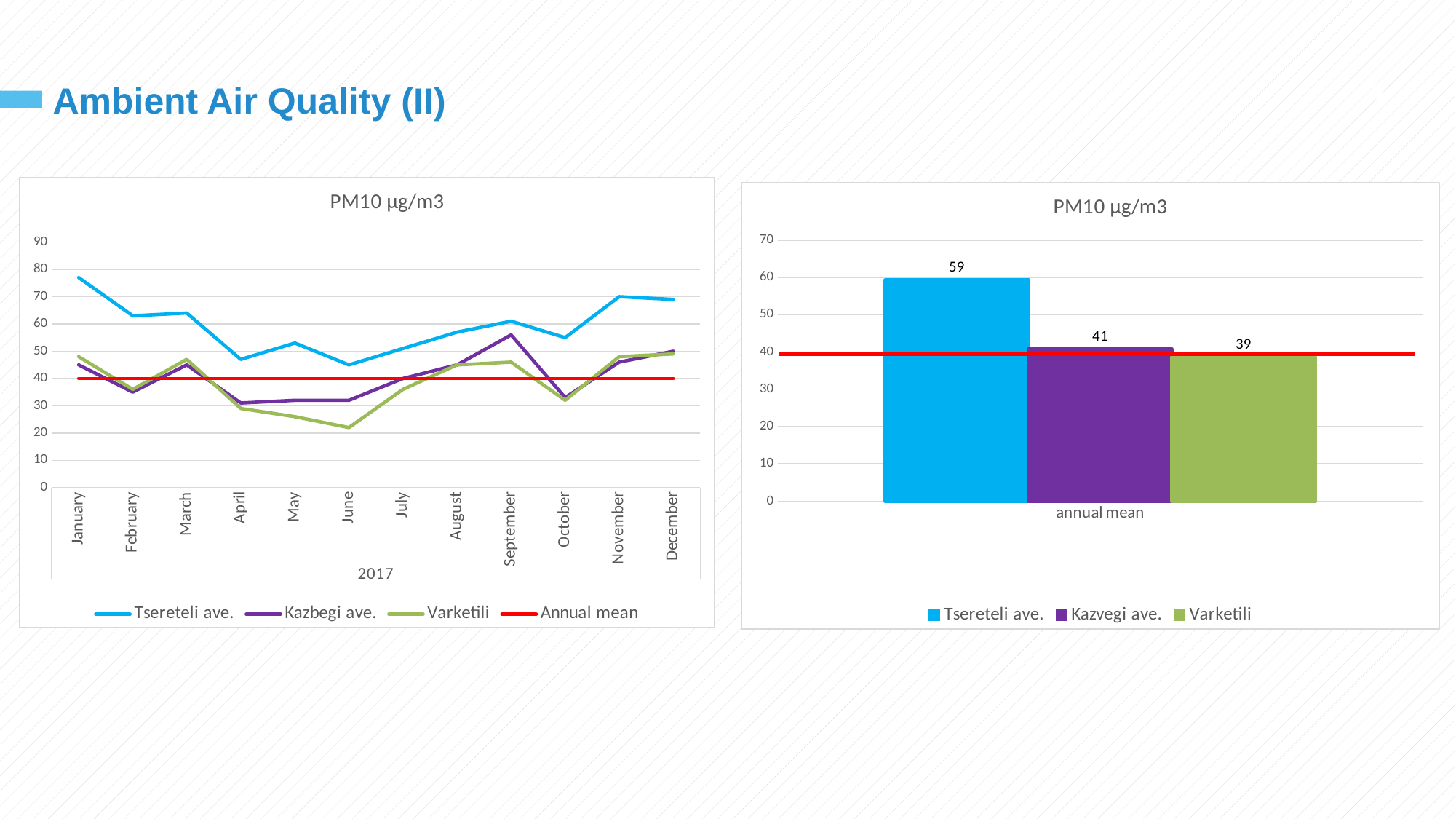
In the bar chart on the right, what is the annual mean PM10 value for Varketili? 39 In the bar chart on the right, what is the difference between the annual mean values for Tsereteli ave. and Kazvegi ave.? 18 In the bar chart on the right, what is the annual mean PM10 value for Tsereteli ave.? 59 In the line chart on the left, is the value for Varketili in June greater or less than 30? less In the line chart on the left, how many months are shown on the x axis? 12 In the bar chart on the right, which station has the lowest annual mean PM10 value? Varketili In the line chart on the left, what value does the red Annual mean line sit at? 40 In the line chart on the left, which series has the highest value in January? Tsereteli ave. In the line chart on the left, is the value for Tsereteli ave. in January greater or less than 70? greater In the bar chart on the right, how many series does the legend list? 3 What kind of chart is the chart on the left of the slide? line chart In the bar chart on the right, which station has the highest annual mean PM10 value? Tsereteli ave.